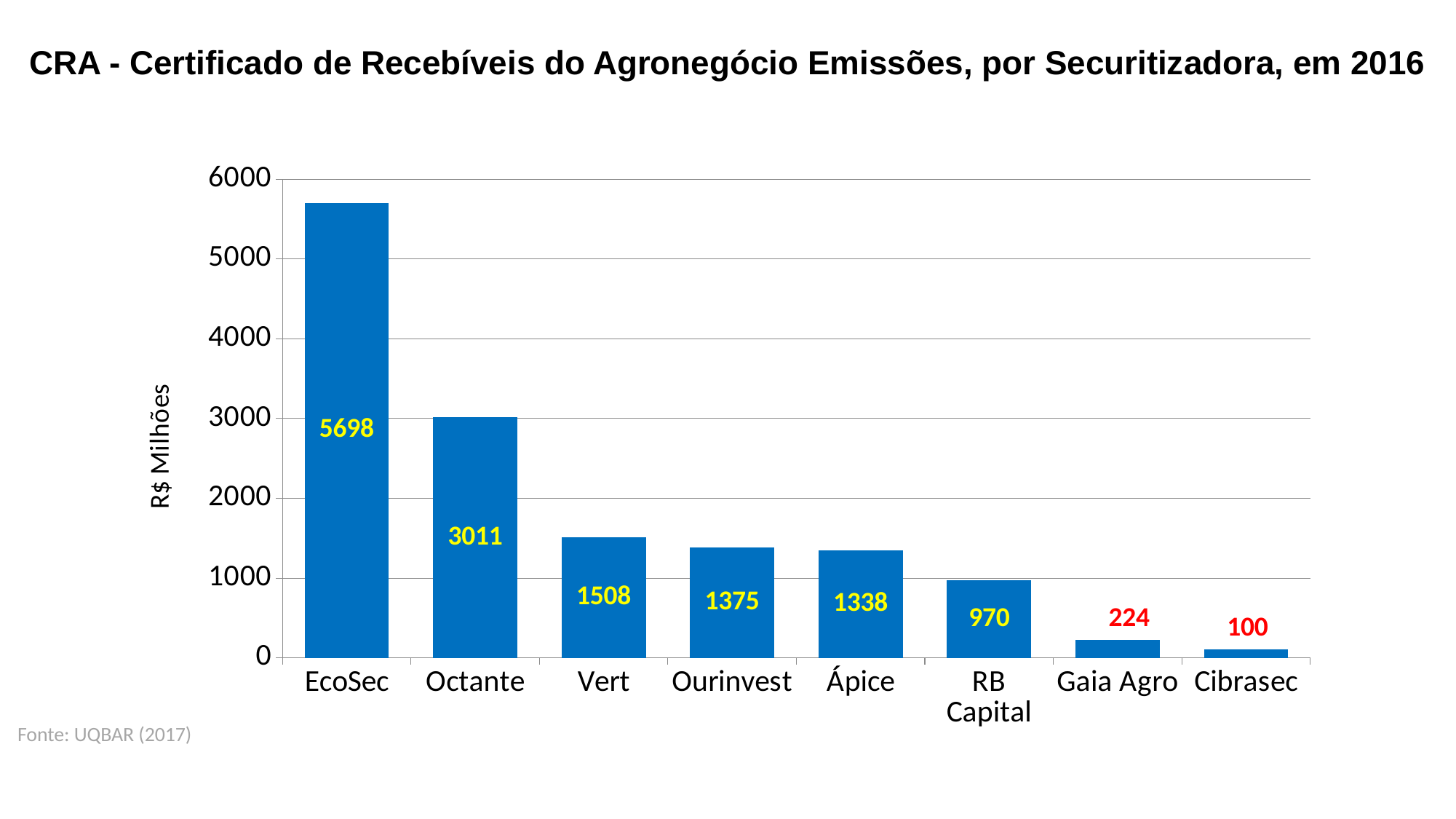
Which is larger, the value for Ápice or the value for RB Capital? Ápice Which securitizadora has the lowest value? Cibrasec How many securitizadoras are shown on the x axis? 8 What is the value for EcoSec? 5698 What is the value for Gaia Agro? 224 What is the label of the y axis? R$ Milhões What is the value for RB Capital? 970 Is the value for Octante greater or less than 2000? greater What is the difference between the values for EcoSec and Octante? 2687 What kind of chart is shown on the slide? bar chart What is the difference between the values for Vert and Ourinvest? 133 Which securitizadora has the highest value? EcoSec